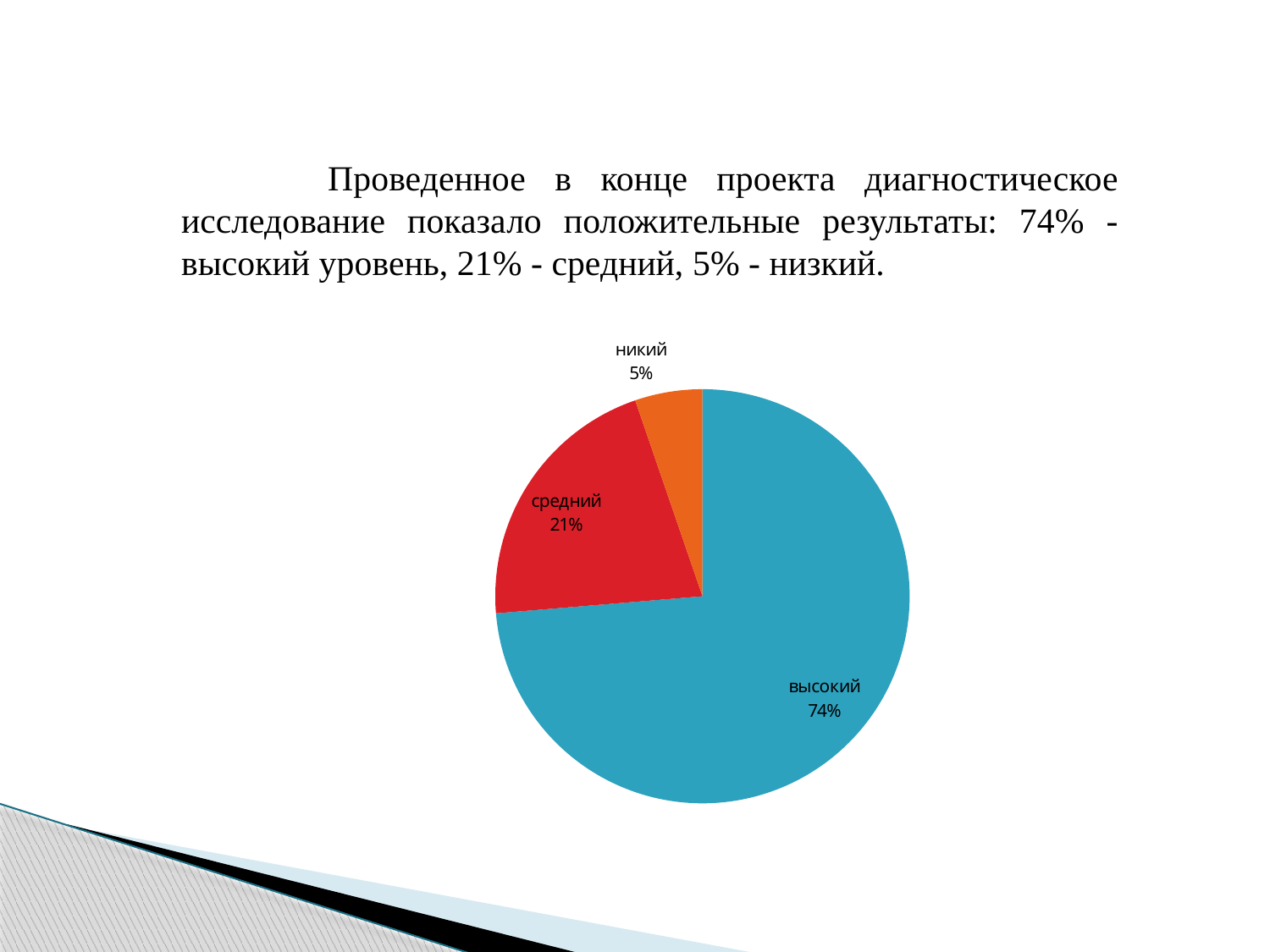
What kind of chart is shown on the slide? pie chart How many slices does the pie chart have? 3 What share of the pie does the "высокий" slice represent? 74% Which slice of the pie is the largest? высокий What colour is the "средний" slice of the pie? red Which slice of the pie is the smallest? никий What is the difference in percentage points between the "средний" and "никий" slices? 16 What colour is the "высокий" slice of the pie? blue What is the difference in percentage points between the "высокий" and "средний" slices? 53 Which is larger, the "средний" slice or the "никий" slice? средний What share of the pie does the "никий" slice represent? 5% What share of the pie does the "средний" slice represent? 21%